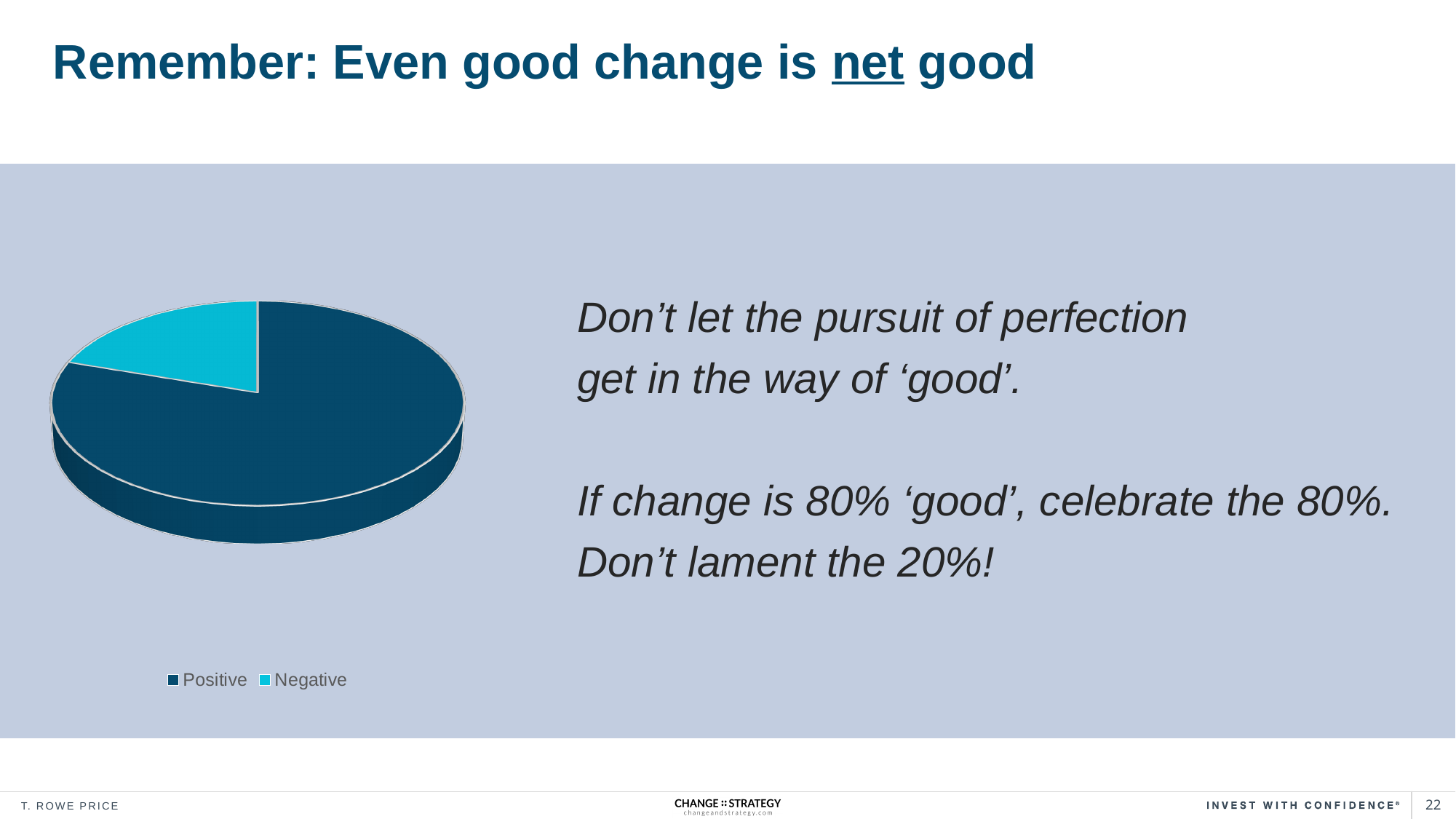
How many slices does the pie chart have? 2 Which slice of the pie chart is the largest? Positive What are the two categories listed in the pie chart's legend? Positive and Negative Does the Positive slice take up more or less than half of the pie chart? More How many entries does the pie chart's legend list? 2 Which legend entry of the pie chart is shown in light cyan? Negative What kind of chart is shown on the slide? Pie chart Which slice of the pie chart is the smallest? Negative Which slice is larger in the pie chart, Positive or Negative? Positive